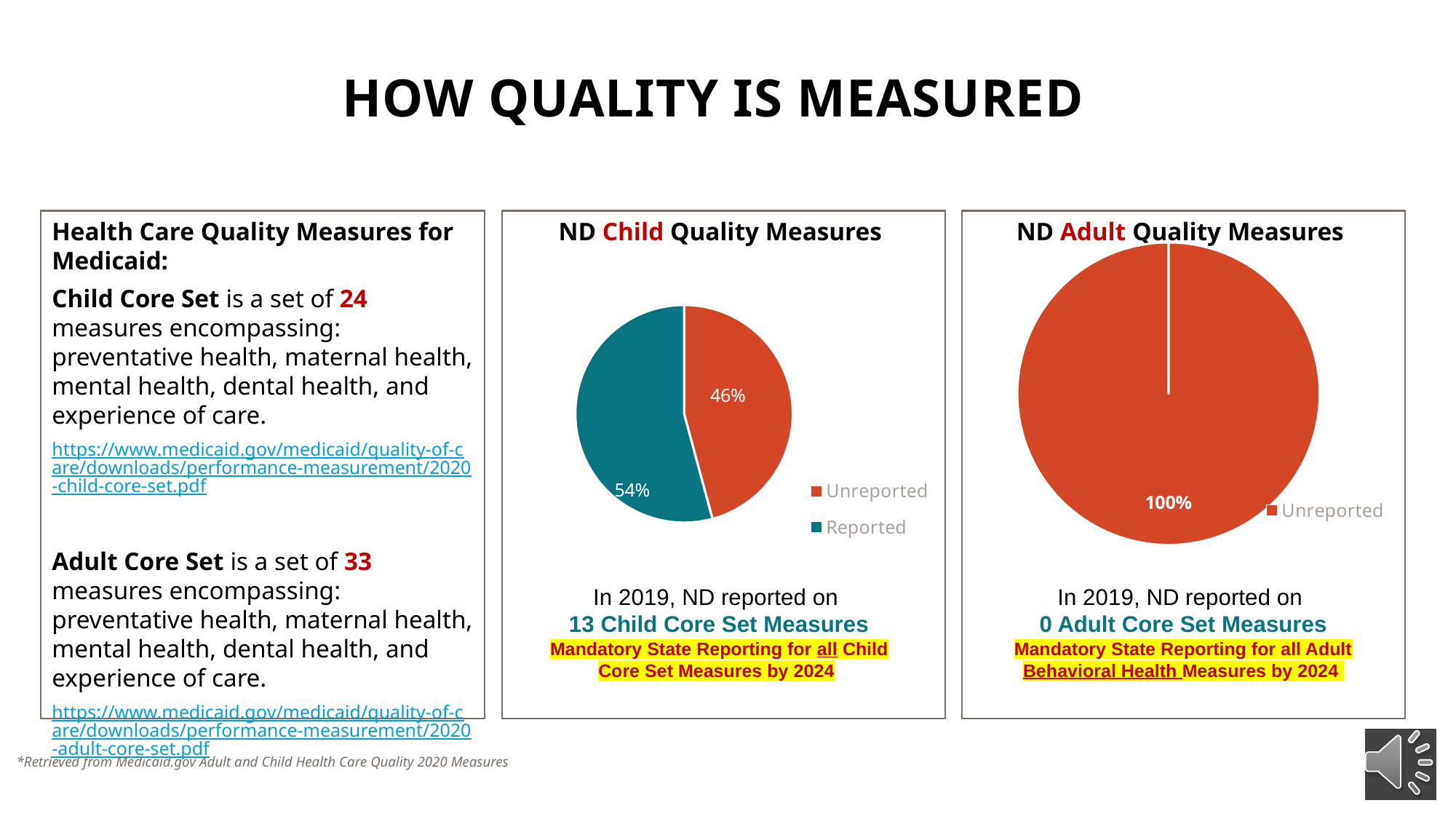
What is the title of the chart on the right side of the slide? ND Adult Quality Measures In the ND Child Quality Measures chart, how many entries does the legend list? 2 In the ND Child Quality Measures chart, which slice is larger, Reported or Unreported? Reported In the ND Child Quality Measures chart, what colour is the Reported slice? Teal What kind of chart is the ND Adult Quality Measures chart? Pie chart In the ND Adult Quality Measures chart, what share of measures is Unreported? 100% In the ND Child Quality Measures chart, how many slices does the pie have? 2 What kind of chart is the ND Child Quality Measures chart? Pie chart In the ND Child Quality Measures chart, what share of measures is Unreported? 46% In the ND Child Quality Measures chart, what is the difference in percentage points between the Reported and Unreported slices? 8 percentage points In the ND Adult Quality Measures chart, how many entries does the legend list? 1 In the ND Child Quality Measures chart, what share of measures is Reported? 54%